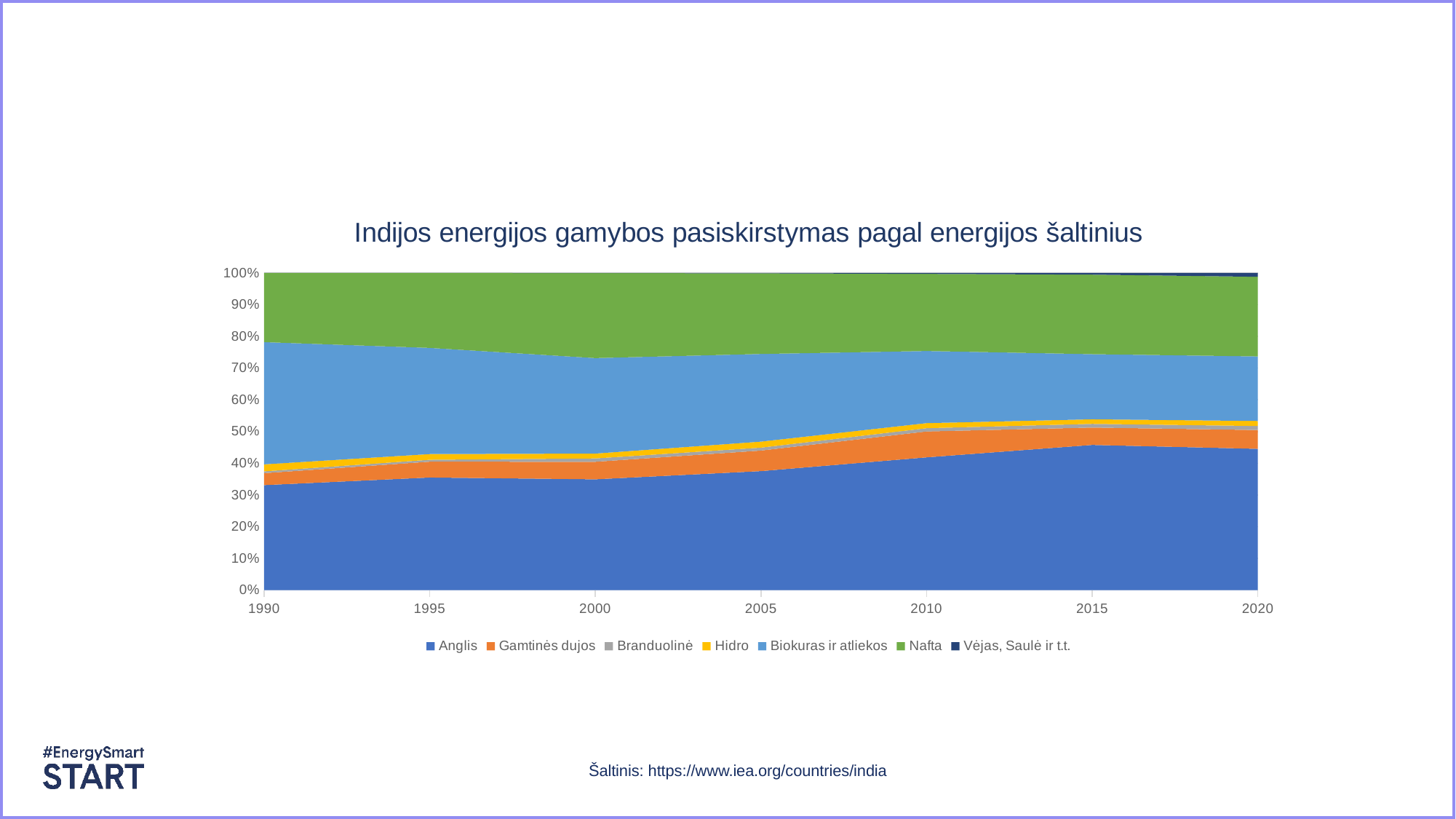
What is the title of the chart? Indijos energijos gamybos pasiskirstymas pagal energijos šaltinius How many series does the legend list? 7 Which series is listed first in the legend? Anglis Which series has the larger share in 1990, Biokuras ir atliekos or Gamtinės dujos? Biokuras ir atliekos Does the share of Biokuras ir atliekos rise or fall from 1990 to 2020? Fall Is the share of Anglis in 2020 greater or less than 50%? less What kind of chart is shown on the slide? Stacked area chart Is the share of Anglis in 1990 greater or less than 40%? less How many years are labelled on the x axis? 7 Does the share of Anglis rise or fall from 1990 to 2015? Rise Which series has the largest share in 2020, Anglis or Nafta? Anglis Is the share of Anglis in 2015 greater or less than 40%? greater